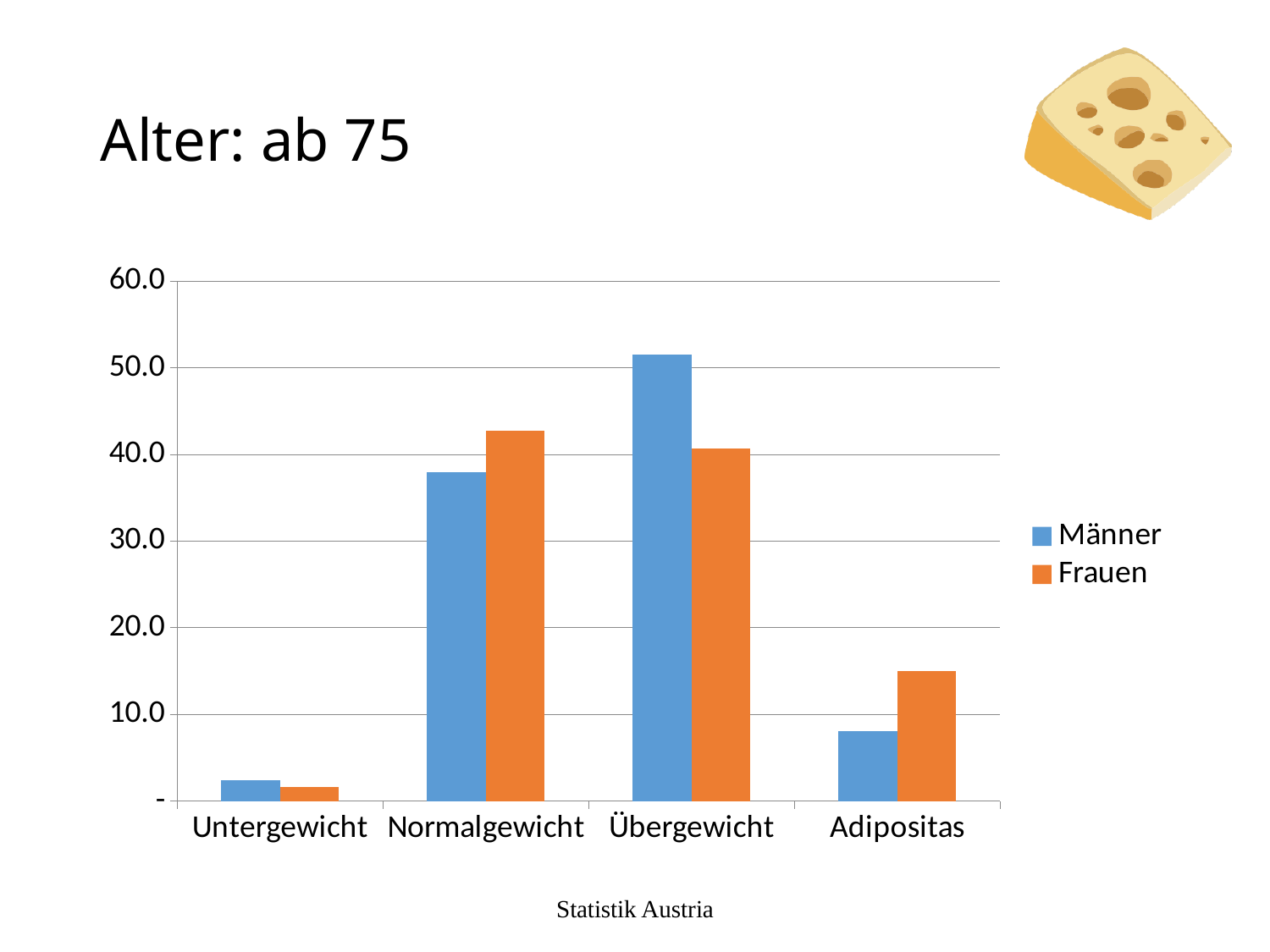
Which category has the lowest value for Frauen? Untergewicht For Normalgewicht, which series has the larger value, Männer or Frauen? Frauen For Übergewicht, which series has the larger value, Männer or Frauen? Männer How many categories are shown on the x axis of the chart? 4 Is the value for Frauen in Adipositas greater or less than 10.0? greater For Adipositas, which series has the larger value, Männer or Frauen? Frauen What kind of chart is shown on the slide? bar chart Which category has the lowest value for Männer? Untergewicht Which category has the highest value for Männer? Übergewicht How many series does the chart's legend list? 2 Which series is shown in orange in the chart's legend? Frauen Is the value for Männer in Übergewicht greater or less than 40.0? greater